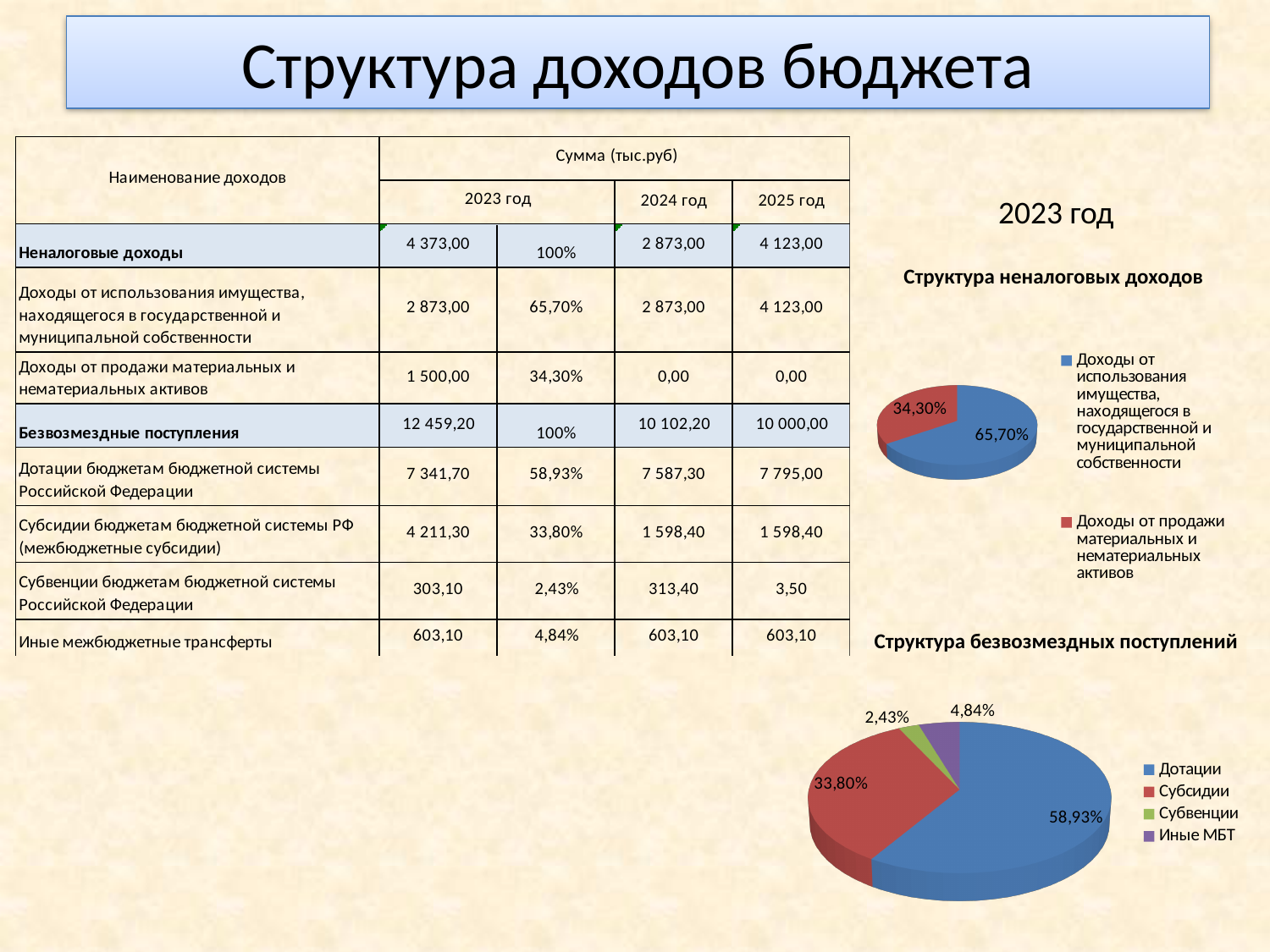
In the 'Структура неналоговых доходов' chart, what share is shown for 'Доходы от продажи материальных и нематериальных активов'? 34,30% In the 'Структура безвозмездных поступлений' chart, which slice is the smallest? Субвенции In the 'Структура неналоговых доходов' chart, which slice is the largest? Доходы от использования имущества, находящегося в государственной и муниципальной собственности In the 'Структура безвозмездных поступлений' chart, how many entries does the legend list? 4 In the 'Структура безвозмездных поступлений' chart, what share is shown for 'Дотации'? 58,93% In the 'Структура неналоговых доходов' chart, how many slices does the pie have? 2 What kind of chart is the 'Структура неналоговых доходов' chart? pie chart In the 'Структура безвозмездных поступлений' chart, what share is shown for 'Субсидии'? 33,80% In the 'Структура безвозмездных поступлений' chart, what is the difference between the shares for 'Дотации' and 'Субсидии'? 25,13%